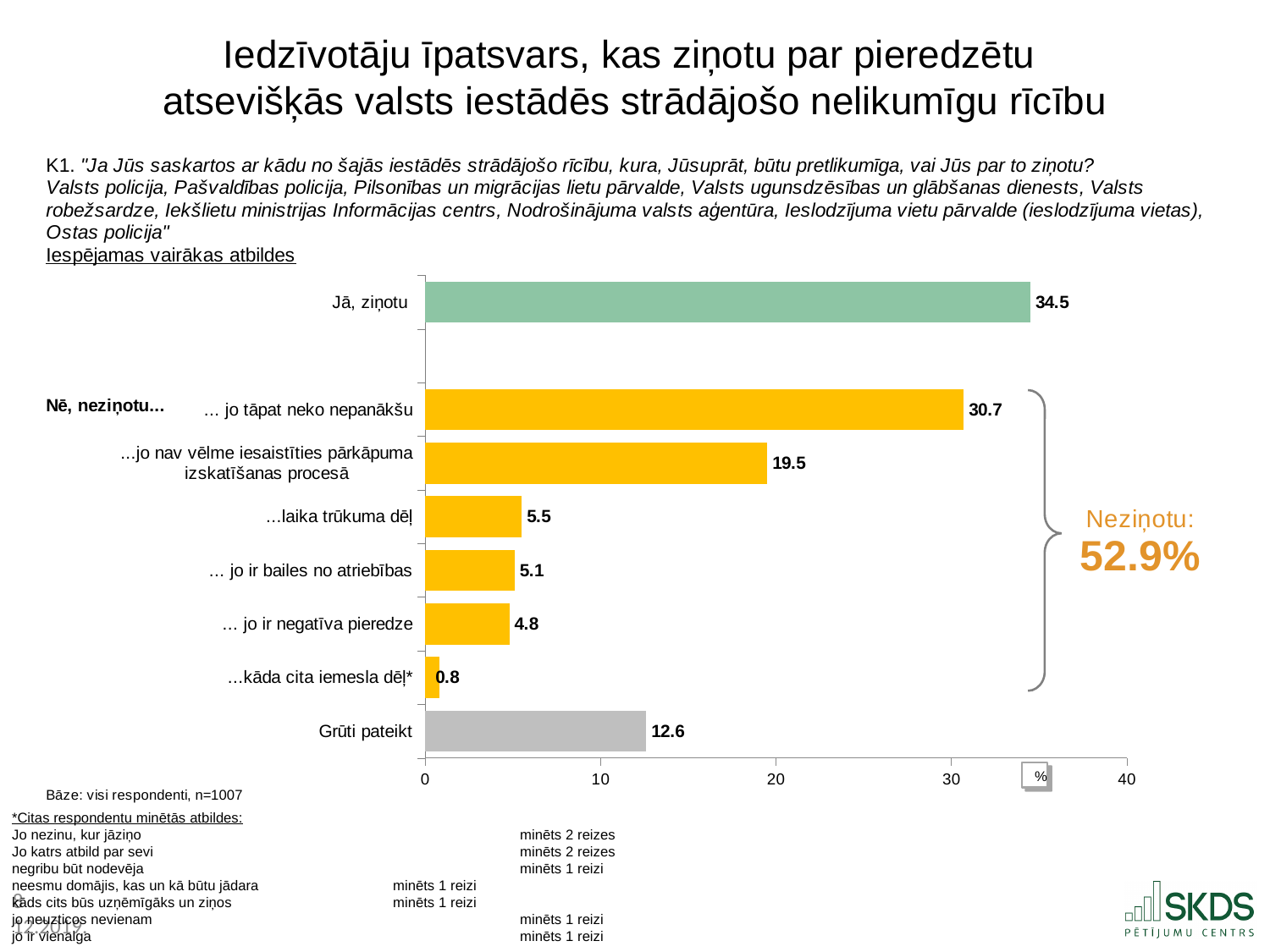
What is the value for "… jo tāpat neko nepanākšu"? 30.7 What is the value for "… jo ir bailes no atriebības"? 5.1 How many categories are plotted in the chart? 8 Which category has the lowest value? …kāda cita iemesla dēļ* What total percentage is shown next to the bracket labelled "Neziņotu"? 52.9% Is the value for "…jo nav vēlme iesaistīties pārkāpuma izskatīšanas procesā" greater or less than 20? less What kind of chart is shown on the slide? bar chart Which is larger: "…laika trūkuma dēļ" or "… jo ir negatīva pieredze"? …laika trūkuma dēļ What is the value for "Grūti pateikt"? 12.6 What is the difference between "Jā, ziņotu" and "… jo tāpat neko nepanākšu"? 3.8 What is the value for "Jā, ziņotu"? 34.5 Which category has the highest value? Jā, ziņotu